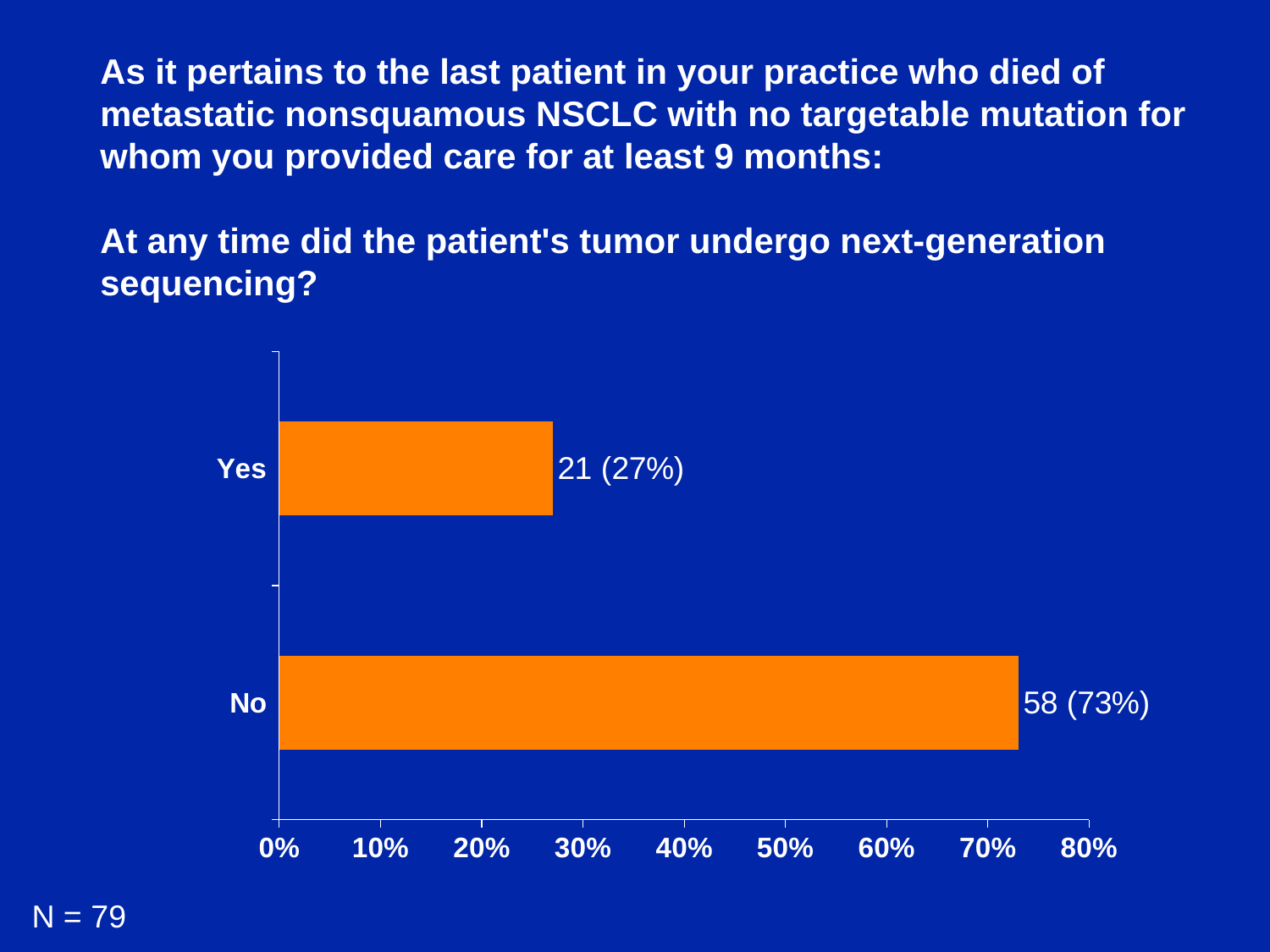
How many respondents answered "Yes"? 21 What is the difference in the number of respondents between "No" and "Yes"? 37 What is the N value shown on the slide? N = 79 Which category has the lowest value? Yes What is the data label shown for the "Yes" bar? 21 (27%) Is the value for "No" greater or less than 50%? greater How many categories are shown in the chart? 2 What percentage of respondents answered "No"? 73% Which is larger, the value for "Yes" or the value for "No"? No What kind of chart is shown on the slide? Bar chart What is the data label shown for the "No" bar? 58 (73%) Which category has the highest value? No